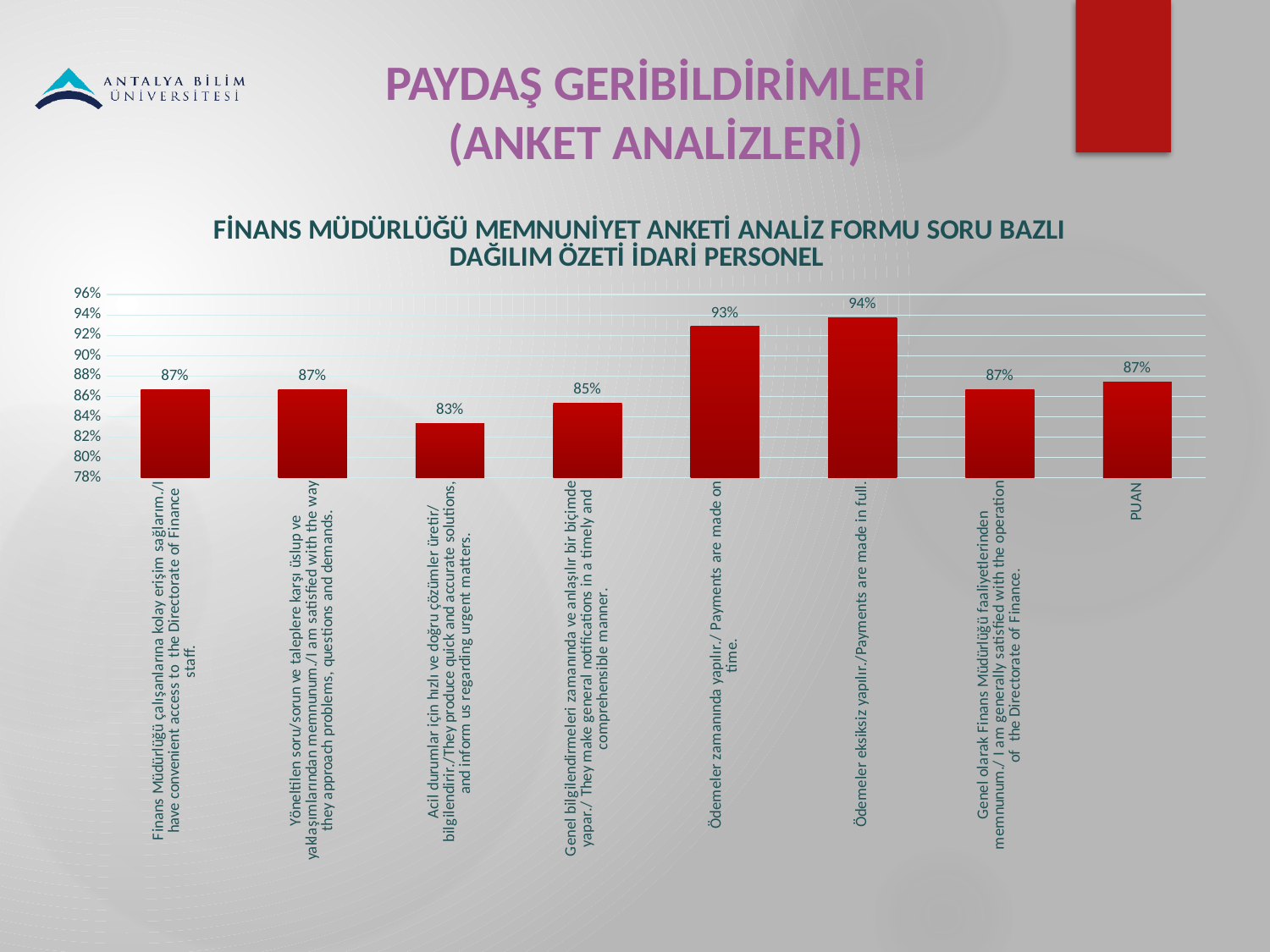
What is the value for 'Ödemeler eksiksiz yapılır./Payments are made in full.'? 94% What is the title of the chart? FİNANS MÜDÜRLÜĞÜ MEMNUNİYET ANKETİ ANALİZ FORMU SORU BAZLI DAĞILIM ÖZETİ İDARİ PERSONEL What is the value for 'Ödemeler zamanında yapılır./ Payments are made on time.'? 93% How many bars (categories) does the chart show? 8 What is the difference between the value for 'Payments are made in full' and the value for 'Acil durumlar için hızlı ve doğru çözümler üretir'? 11% Which is larger: the value for 'Payments are made on time' or the value for 'Genel bilgilendirmeleri zamanında ve anlaşılır bir biçimde yapar'? Payments are made on time Which category has the lowest value? Acil durumlar için hızlı ve doğru çözümler üretir/bilgilendirir./They produce quick and accurate solutions, and inform us regarding urgent matters. Is the value for 'Genel bilgilendirmeleri zamanında ve anlaşılır bir biçimde yapar' greater or less than 90%? less What is the value for the category beginning 'Acil durumlar için hızlı ve doğru çözümler üretir'? 83% Which category has the highest value? Ödemeler eksiksiz yapılır./Payments are made in full. What type of chart is shown on the slide? bar chart What is the value for the category 'PUAN'? 87%